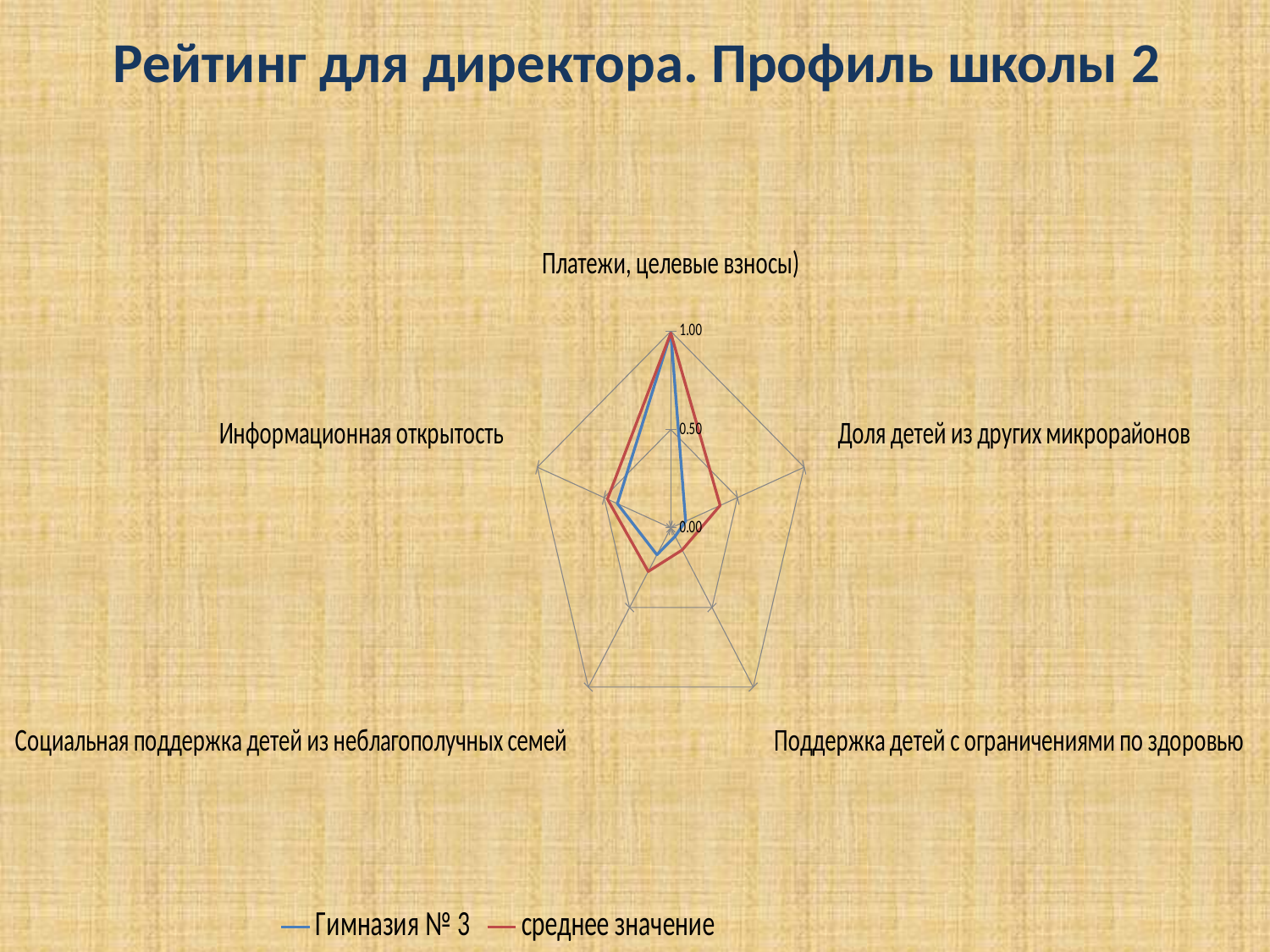
Is the value of среднее значение for Поддержка детей с ограничениями по здоровью greater or less than 0.50? less For Доля детей из других микрорайонов, which series has the larger value, Гимназия № 3 or среднее значение? среднее значение What kind of chart is shown on the slide? Radar chart Is the value of Гимназия № 3 for Платежи, целевые взносы) greater or less than 0.50? greater Which series is drawn in red? среднее значение For Поддержка детей с ограничениями по здоровью, which series has the larger value, Гимназия № 3 or среднее значение? среднее значение How many series does the legend list? 2 Which series is drawn in blue? Гимназия № 3 Is the value of Гимназия № 3 for Доля детей из других микрорайонов greater or less than 0.50? less How many categories (axes) does the radar chart have? 5 On which category does среднее значение reach its highest value? Платежи, целевые взносы) On which category does Гимназия № 3 reach its highest value? Платежи, целевые взносы)